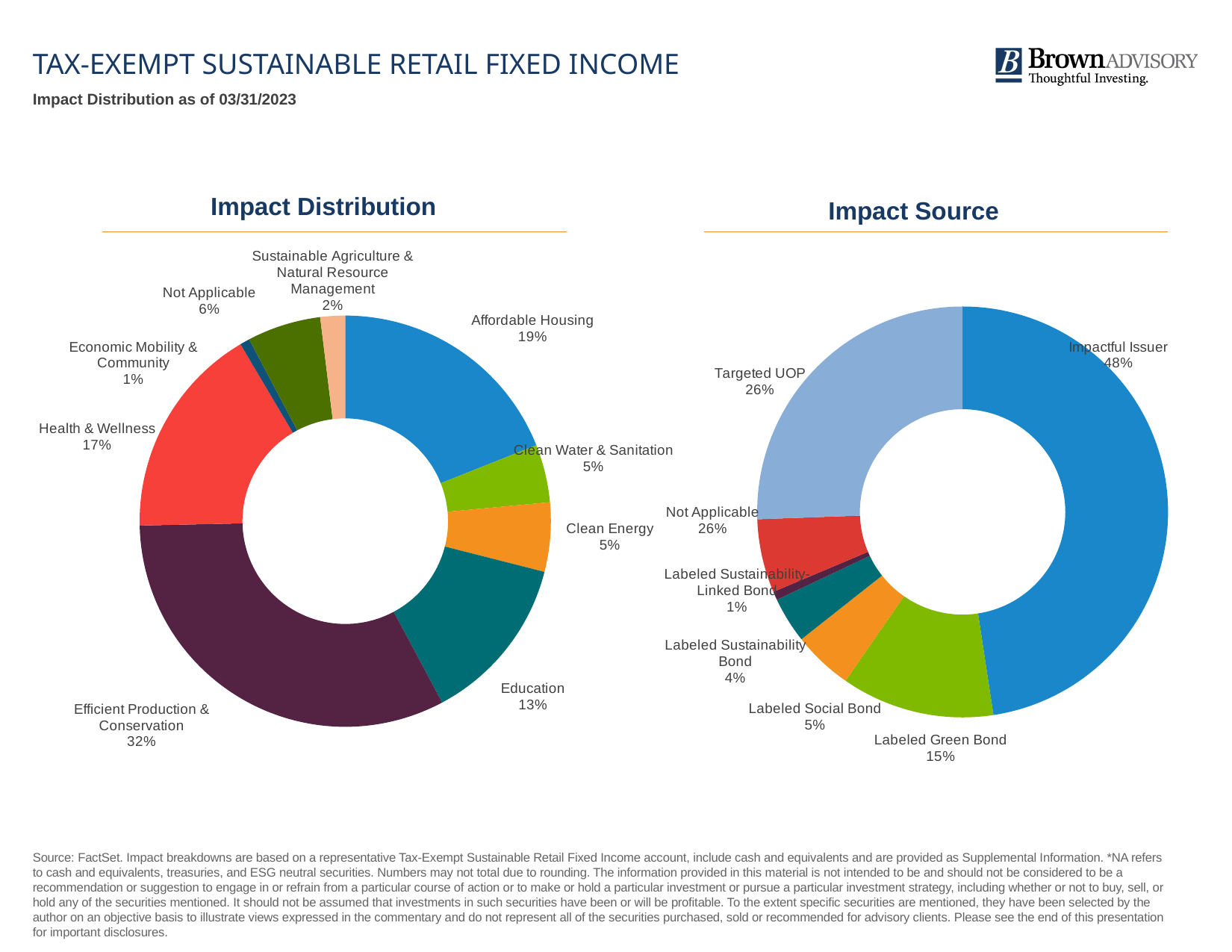
In the Impact Distribution chart, which category has the smallest share? Economic Mobility & Community In the Impact Source chart, which is larger: Labeled Social Bond or Labeled Sustainability Bond? Labeled Social Bond In the Impact Distribution chart, what is the difference between Efficient Production & Conservation and Education? 19% In the Impact Source chart, what share does Impactful Issuer have? 48% In the Impact Source chart, what is the value for Labeled Green Bond? 15% In the Impact Distribution chart, what is the value for Health & Wellness? 17% What kind of chart is the Impact Source chart? Pie chart (donut) In the Impact Distribution chart, what share does Affordable Housing have? 19% In the Impact Source chart, how many categories are shown? 7 In the Impact Distribution chart, which category has the largest share? Efficient Production & Conservation In the Impact Distribution chart, how many categories are shown? 9 In the Impact Source chart, which category has the smallest share? Labeled Sustainability-Linked Bond